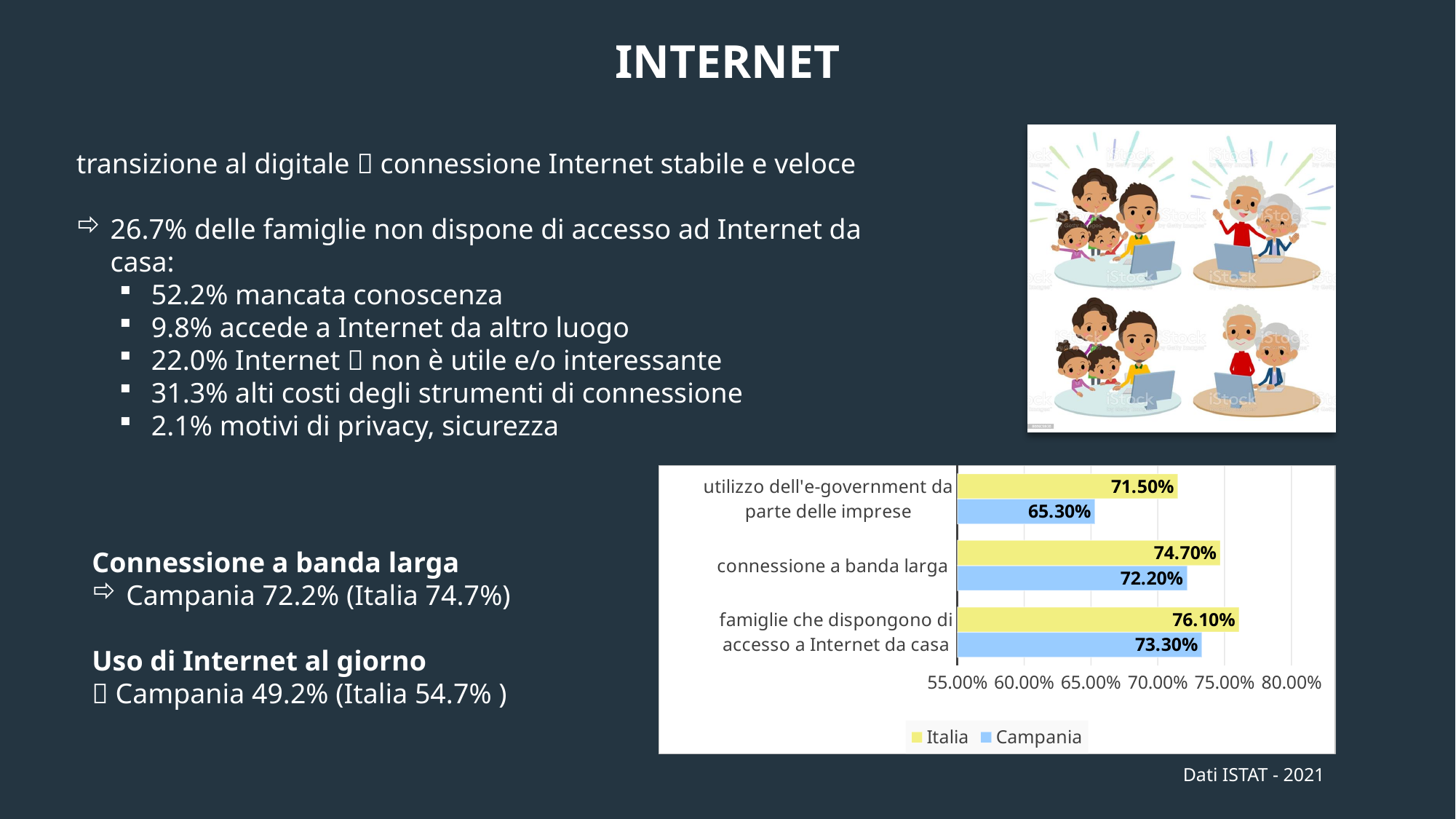
Which category has the highest value for Italia? famiglie che dispongono di accesso a Internet da casa Which category has the lowest value for Campania? utilizzo dell'e-government da parte delle imprese What is the difference between the Italia and Campania values for 'utilizzo dell'e-government da parte delle imprese'? 6.20% Is the Campania value for 'utilizzo dell'e-government da parte delle imprese' greater or less than 70.00%? less What is the value for Campania in the category 'utilizzo dell'e-government da parte delle imprese'? 65.30% How many categories are shown on the chart? 3 How many series does the chart legend list? 2 What is the value for Italia in the category 'connessione a banda larga'? 74.70% What is the value for Campania in the category 'famiglie che dispongono di accesso a Internet da casa'? 73.30% Which is larger in the category 'connessione a banda larga': the Italia value or the Campania value? Italia Which colour represents Campania in the chart? blue What kind of chart is shown on the slide? bar chart